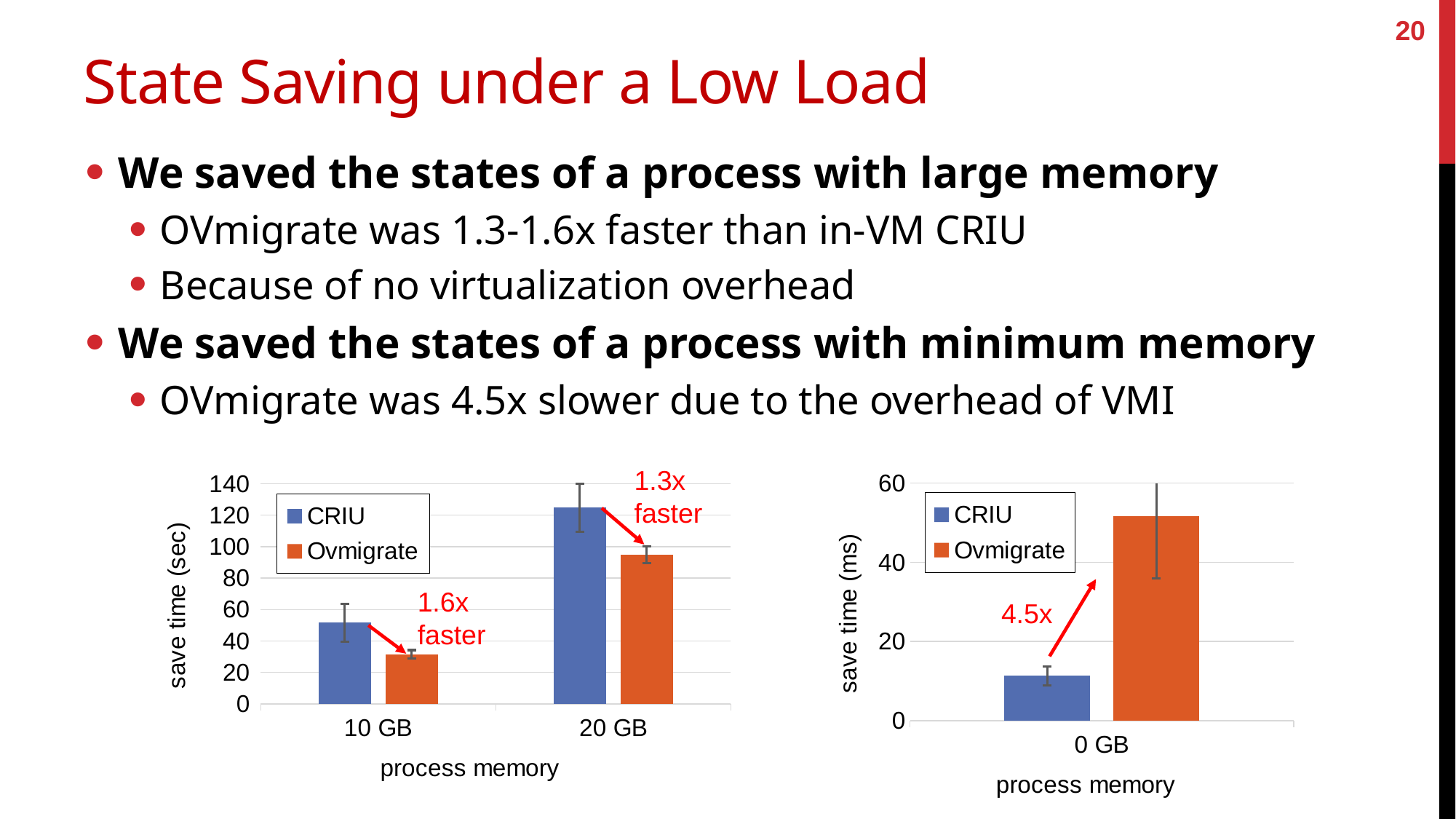
In the left chart (save time in sec), is the Ovmigrate value for 10 GB greater or less than 40? less In the left chart (save time in sec), which series has the larger value at 20 GB, CRIU or Ovmigrate? CRIU In the left chart (save time in sec), is the CRIU value for 10 GB greater or less than 40? greater In the left chart (save time in sec), how many process memory categories are shown on the x axis? 2 In the left chart (save time in sec), how many series does the legend list? 2 In the left chart (save time in sec), does the CRIU save time rise or fall from 10 GB to 20 GB? rise In the right chart (save time in ms), is the Ovmigrate value for 0 GB greater or less than 40? greater In the left chart (save time in sec), what speedup is annotated for Ovmigrate at 10 GB? 1.6x faster In the right chart (save time in ms), which series has the larger value at 0 GB, CRIU or Ovmigrate? Ovmigrate What kind of chart is the left chart (save time in sec)? bar chart